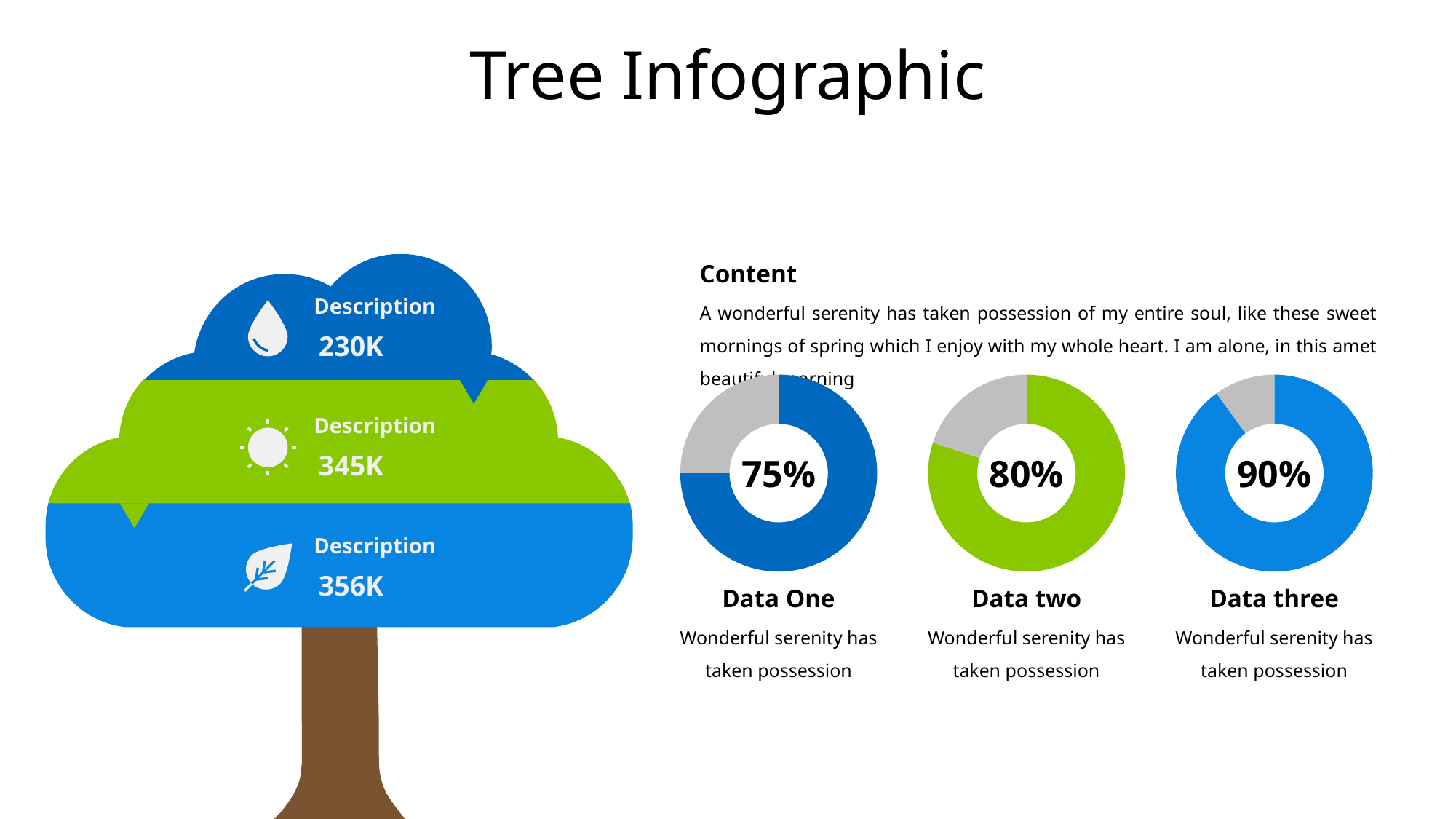
Which shows a larger percentage, the Data two donut chart or the Data One donut chart? Data two What is the difference between the percentage shown for Data two and the percentage shown for Data One? 5% What kind of chart is used to display the Data One, Data two and Data three values? Donut chart Among the three donut charts, which one shows the highest percentage? Data three What value is shown in the centre of the Data two donut chart? 80% What value is shown in the centre of the Data three donut chart? 90% Among the three donut charts, which one shows the lowest percentage? Data One What is the difference between the percentage shown for Data three and the percentage shown for Data One? 15% What share of the Data One donut chart is left unfilled (grey)? 25% What colour is the filled portion of the Data two donut chart? Green What value is shown in the centre of the Data One donut chart? 75% How many donut charts are shown on the slide? 3